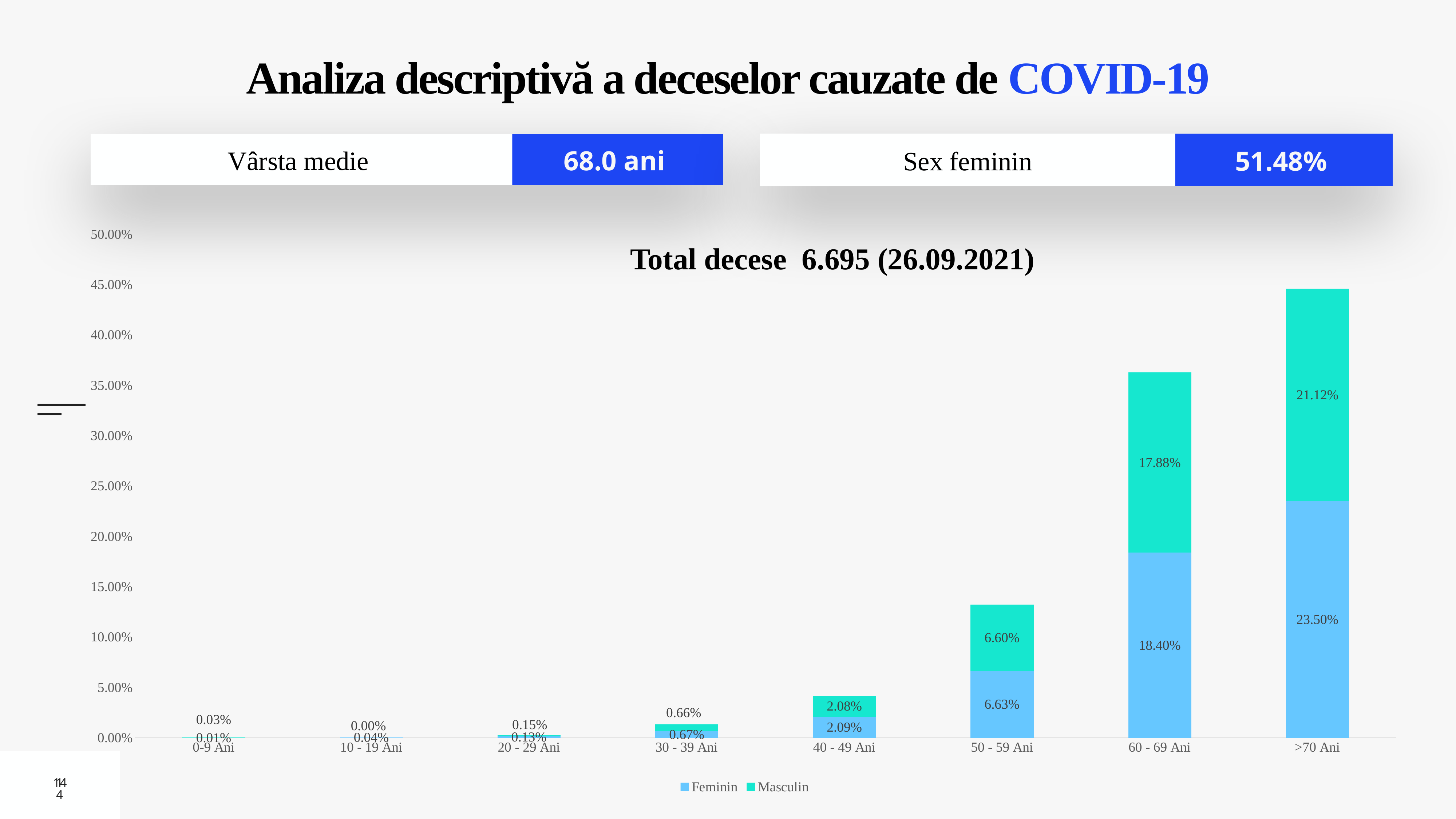
How many series does the legend list? 2 What is the Masculin value for the >70 Ani age group? 21.12% What type of chart is shown on the slide? stacked bar chart Is the total of the stacked bar for the >70 Ani age group greater or less than 40.00%? greater What is the Feminin value for the 60 - 69 Ani age group? 18.40% Which series is shown in the darker teal colour in the legend? Masculin What is the total of the stacked bar for the 60 - 69 Ani age group? 36.28% What is the Masculin value for the 50 - 59 Ani age group? 6.60% Which age group has the highest Feminin value? >70 Ani What is the difference between the Feminin and Masculin values for the >70 Ani age group? 2.38% Which age group has the lowest Masculin value? 10 - 19 Ani How many age groups are shown on the x axis? 8